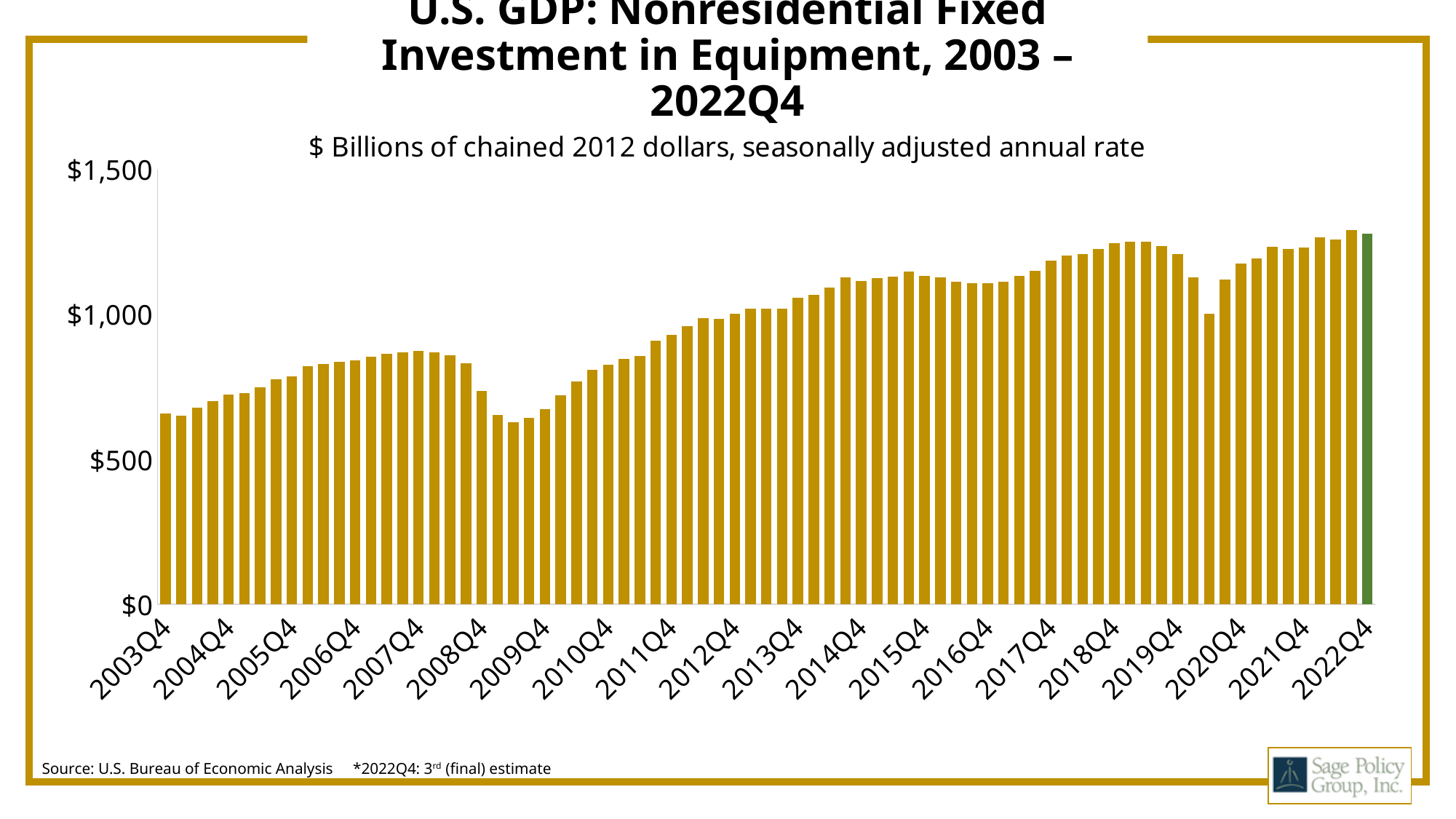
How many year-quarter labels are shown on the x axis? 20 Which is larger, the value for 2007Q4 or the value for 2009Q4? 2007Q4 Is the value for 2014Q4 greater or less than $1,000? greater What units does the chart subtitle say the values are in? $ Billions of chained 2012 dollars, seasonally adjusted annual rate Is the value for 2009Q4 greater or less than $1,000? less Is the value for 2003Q4 greater or less than $500? greater What kind of chart is shown on the slide? bar chart Which is larger, the value for 2022Q4 or the value for 2003Q4? 2022Q4 Do the values generally rise or fall from 2003Q4 to 2007Q4? rise Do the values rise or fall from 2008Q4 to 2009Q4? fall